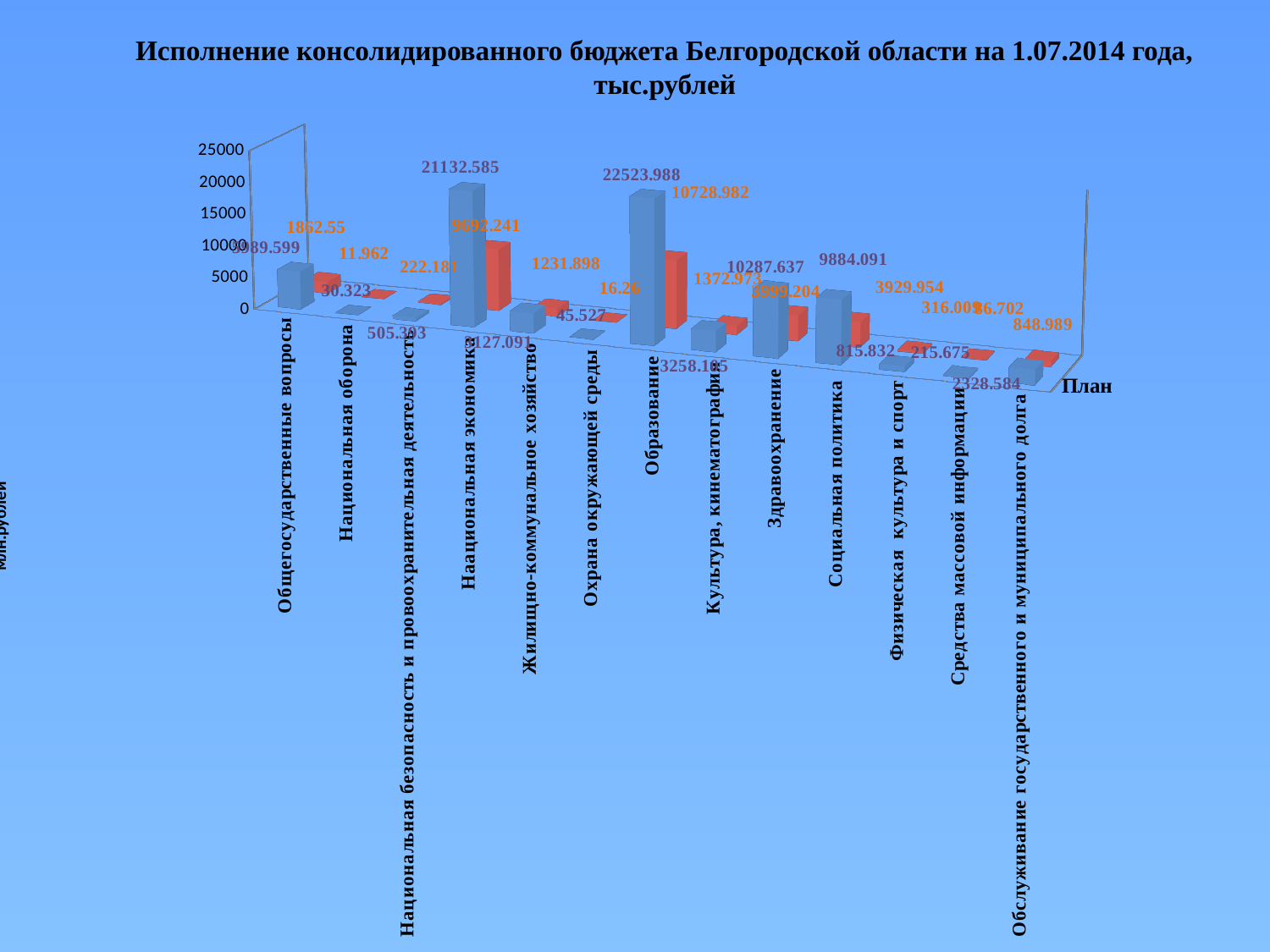
Which category has the highest План value? Образование What is the План value for Здравоохранение? 10287.637 What is the План value for Национальная экономика? 21132.585 How many expenditure categories are shown along the x axis? 13 What is the План value for Образование? 22523.988 What is the value of the red bar for Национальная экономика? 9692.241 Which has the larger План value, Здравоохранение or Социальная политика? Здравоохранение What is the title of the chart? Исполнение консолидированного бюджета Белгородской области на 1.07.2014 года, тыс.рублей What is the difference between the План values for Образование and Национальная экономика? 1391.403 What kind of chart is shown on the slide? bar chart Which category has the lowest План value? Национальная оборона What is the value of the red bar for Образование? 10728.982